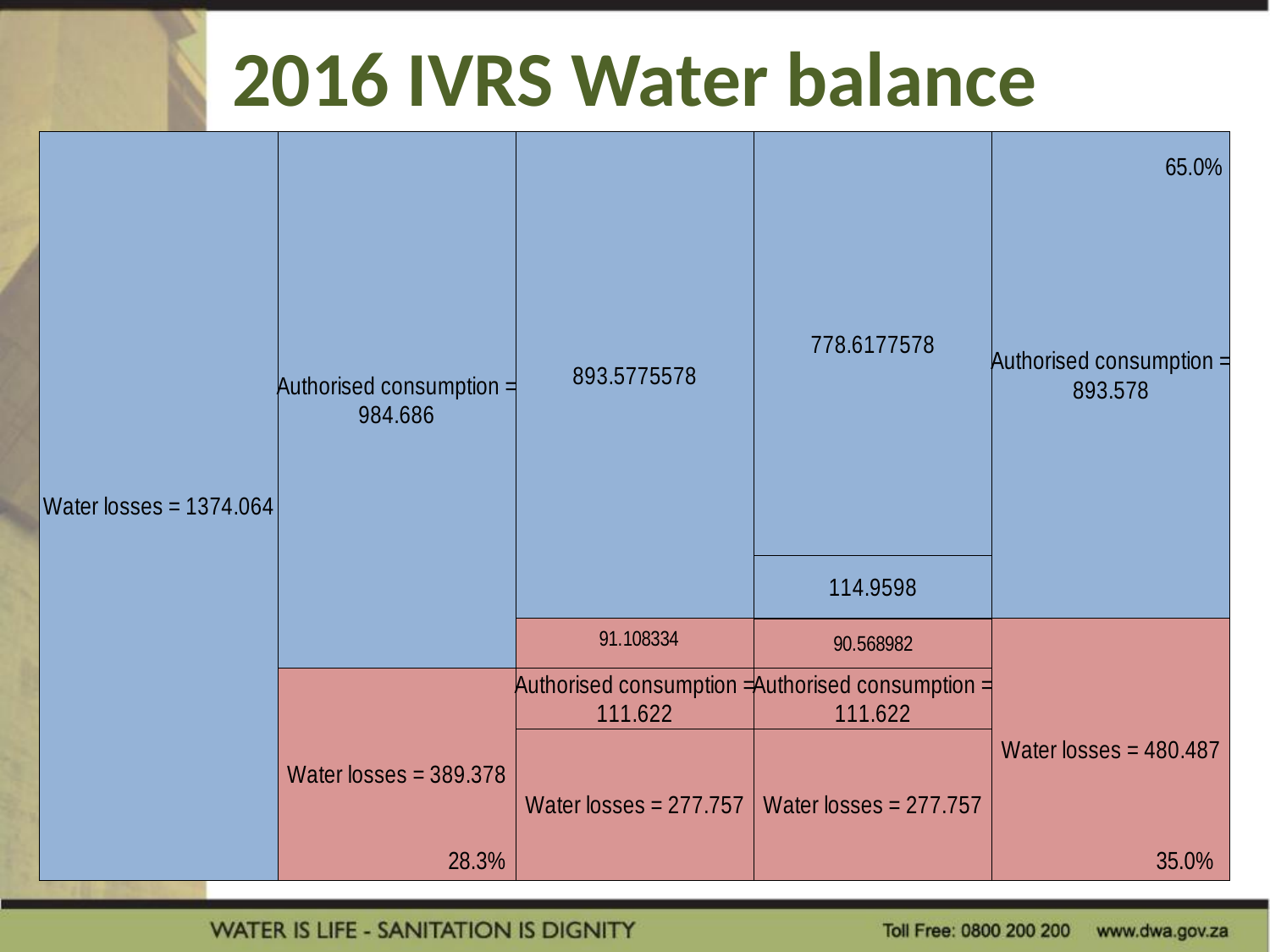
What is the value of Water losses in the rightmost bar? 480.487 What percentage is printed at the top of the rightmost bar? 65.0% What is the difference between Authorised consumption (984.686) and Water losses (389.378) in the second bar from the left? 595.308 How many bars (columns) does the chart contain? 5 What is the value of Authorised consumption in the second bar from the left? 984.686 What is the value of Water losses in the leftmost bar? 1374.064 In the second bar from the left, which is larger: Authorised consumption or Water losses? Authorised consumption What percentage is printed at the bottom of the second bar from the left? 28.3% What is the title of the chart on the slide? 2016 IVRS Water balance What is the value of Authorised consumption in the rightmost bar? 893.578 What is the difference between Authorised consumption (893.578) and Water losses (480.487) in the rightmost bar? 413.091 What kind of chart is shown on the slide? Stacked bar chart